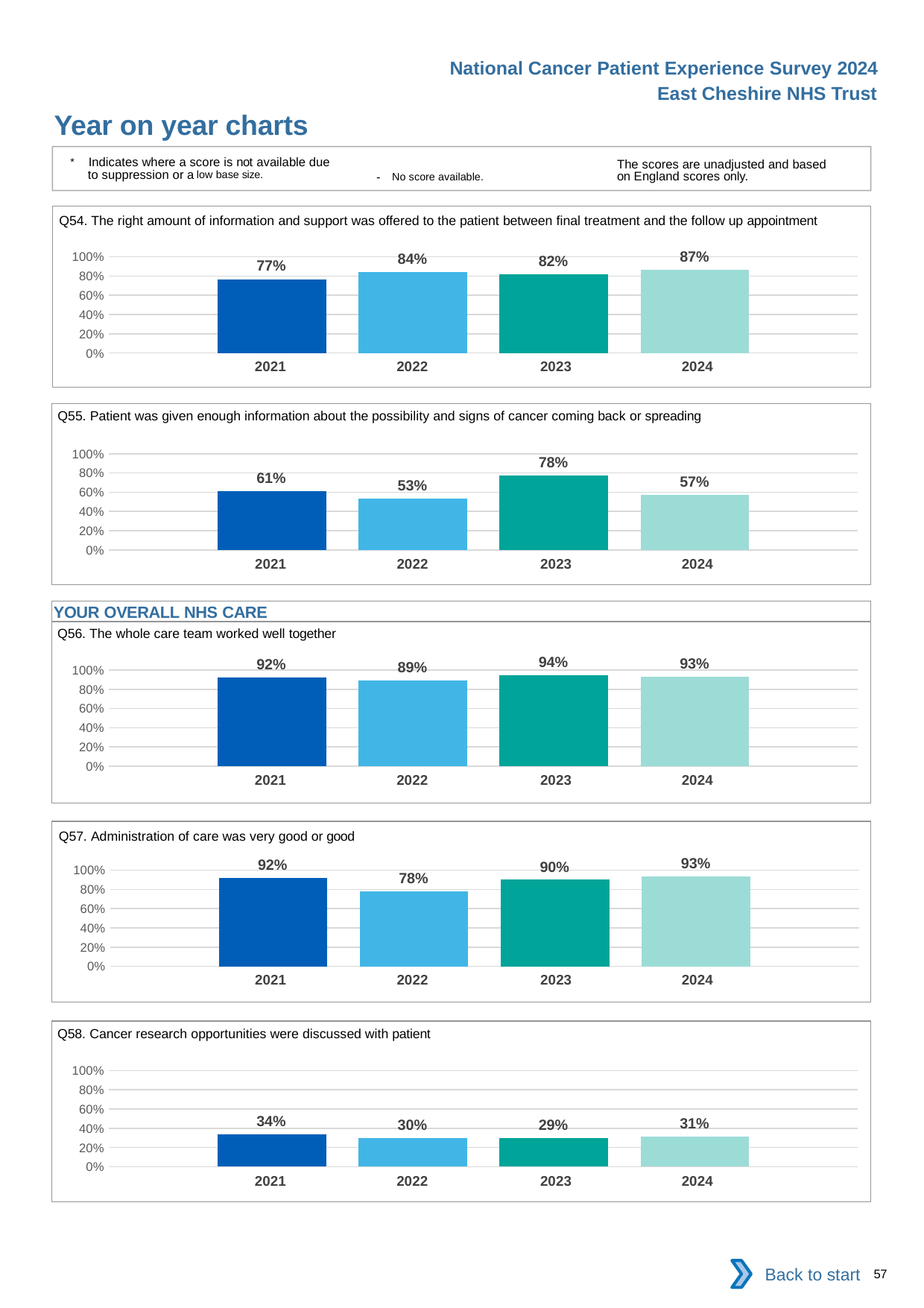
In the Q57 chart, what is the difference between the 2021 and 2022 values? 14% What kind of chart is the Q57 chart? bar chart In the Q58 chart, which year has the lowest value? 2023 How many charts are shown on the slide? 5 How many years are shown in the Q58 chart? 4 In the Q56 chart, which is larger, the value for 2022 or the value for 2023? 2023 In the Q55 chart, which year has the highest value? 2023 In the Q58 chart, is the value for 2021 greater or less than 40%? less In the Q54 chart, what is the value for 2024? 87% In the Q55 chart, which year has the lowest value? 2022 In the Q55 chart, what is the difference between the 2023 and 2024 values? 21% In the Q54 chart, what is the value for 2021? 77%